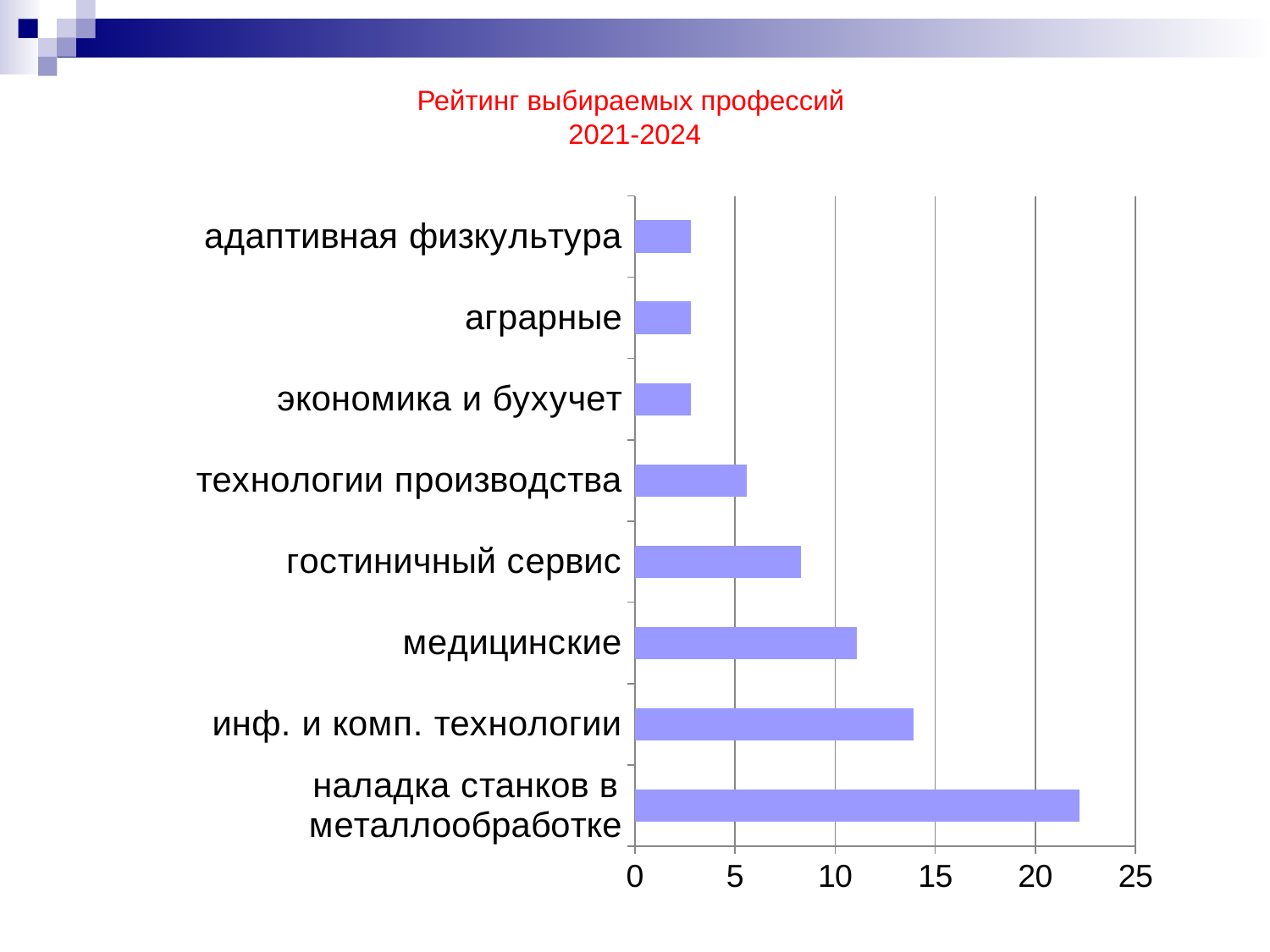
Is the value for наладка станков в металлообработке greater or less than 20? greater Which profession has the highest value in the chart? наладка станков в металлообработке What is the title of the chart on the slide? Рейтинг выбираемых профессий 2021-2024 Which is larger, the value for медицинские or the value for гостиничный сервис? медицинские Is the value for медицинские greater or less than 10? greater Is the value for инф. и комп. технологии greater or less than 15? less What kind of chart is shown on the slide? bar chart What is the highest value shown on the horizontal axis of the chart? 25 Which is larger, the value for инф. и комп. технологии or the value for технологии производства? инф. и комп. технологии How many professions (categories) are plotted in the chart? 8